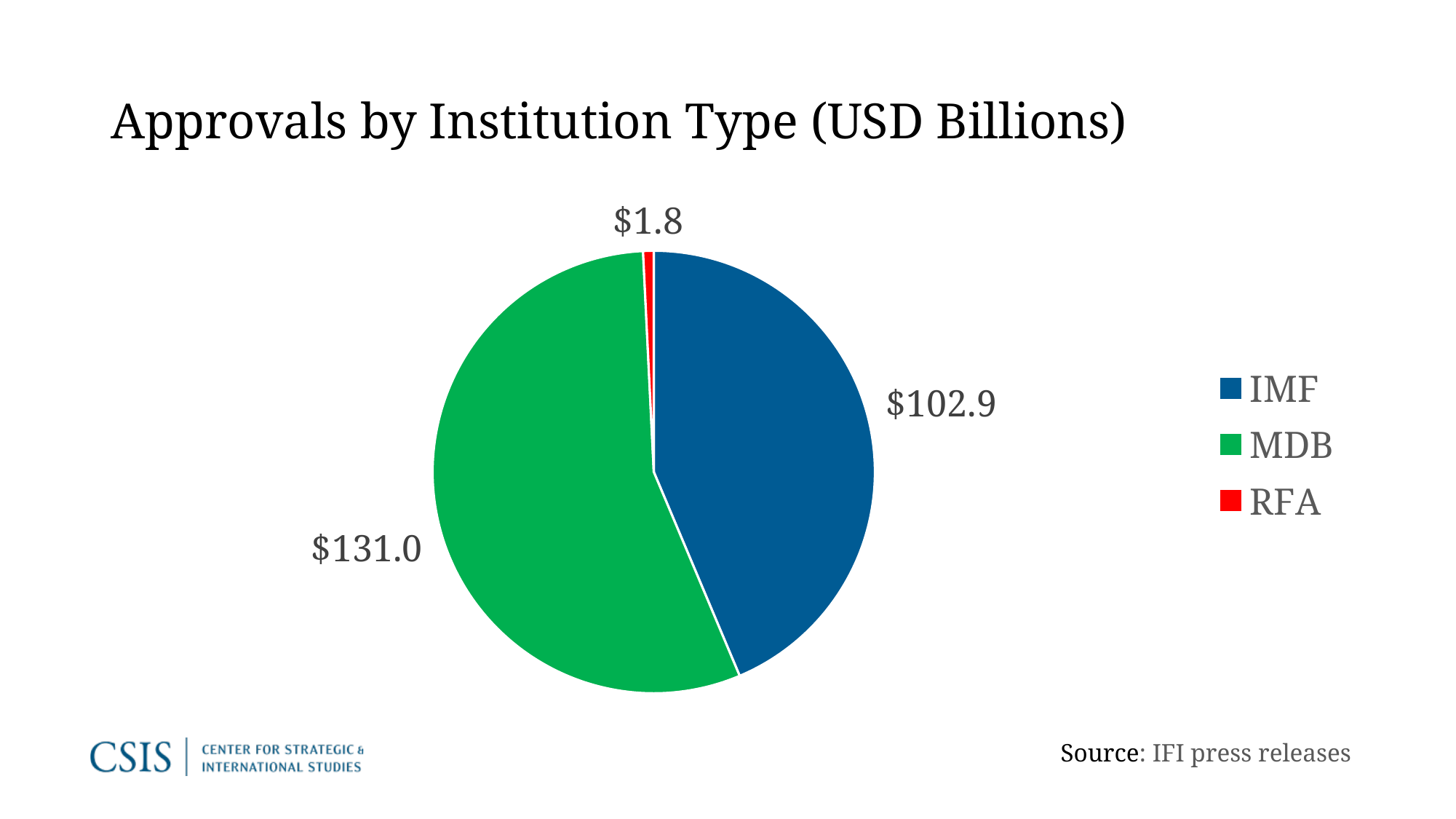
How many slices does the pie chart have? 3 Which is larger, the IMF value or the MDB value? MDB What is the title of the chart? Approvals by Institution Type (USD Billions) What is the value for RFA? $1.8 Which institution type has the largest approvals? MDB Which institution type has the smallest approvals? RFA What is the value for MDB? $131.0 How many entries does the legend list? 3 What is the difference between the MDB and IMF values? $28.1 What is the total of all three slices? $235.7 What is the value for IMF? $102.9 What kind of chart is shown on the slide? Pie chart